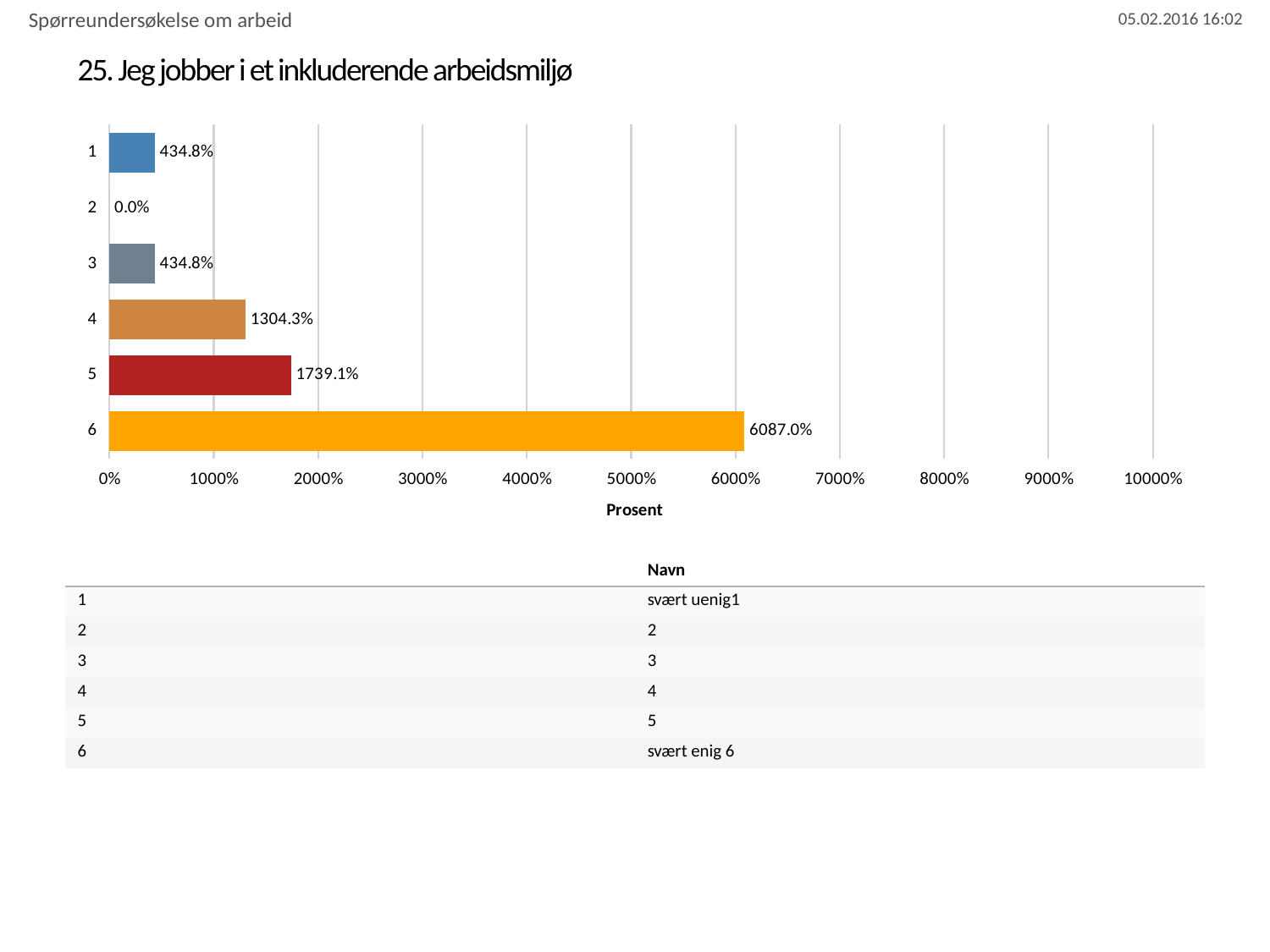
What is the difference between the values for category 5 and category 4? 434.8% What is the value for category 6? 6087.0% Is the value for category 6 greater or less than 5000%? greater Which is larger, the value for category 4 or the value for category 5? 5 What is the value for category 5? 1739.1% What is the value for category 2? 0.0% What is the label of the horizontal axis? Prosent What is the value for category 4? 1304.3% How many categories are shown in the chart? 6 Which category has the highest value? 6 What kind of chart is shown on the slide? bar chart Which category has the lowest value? 2